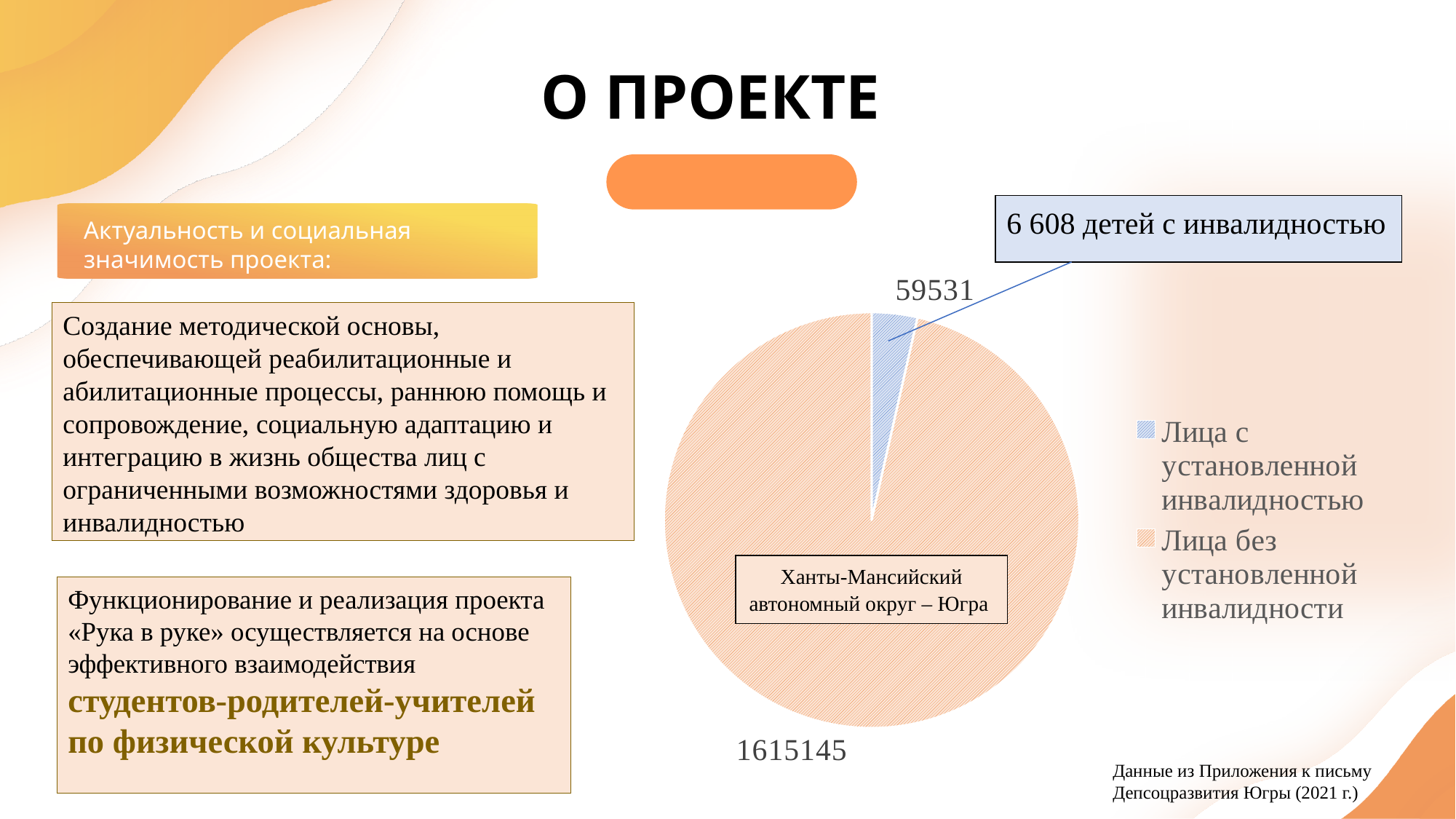
What is the value for "Лица без установленной инвалидности" in the pie chart? 1615145 What number of children with disabilities is stated in the callout pointing to the small slice of the pie chart? 6 608 Which is larger: the value for "Лица с установленной инвалидностью" or the value for "Лица без установленной инвалидности"? Лица без установленной инвалидности Which category has the smallest slice in the pie chart? Лица с установленной инвалидностью How many entries does the legend of the pie chart list? 2 What is the difference between the values for "Лица без установленной инвалидности" and "Лица с установленной инвалидностью"? 1555614 Which region is named in the label inside the pie chart? Ханты-Мансийский автономный округ – Югра How many slices does the pie chart have? 2 What is the value for "Лица с установленной инвалидностью" in the pie chart? 59531 Which category has the largest slice in the pie chart? Лица без установленной инвалидности What kind of chart is shown on the slide? pie chart What is the total of the two values shown in the pie chart? 1674676